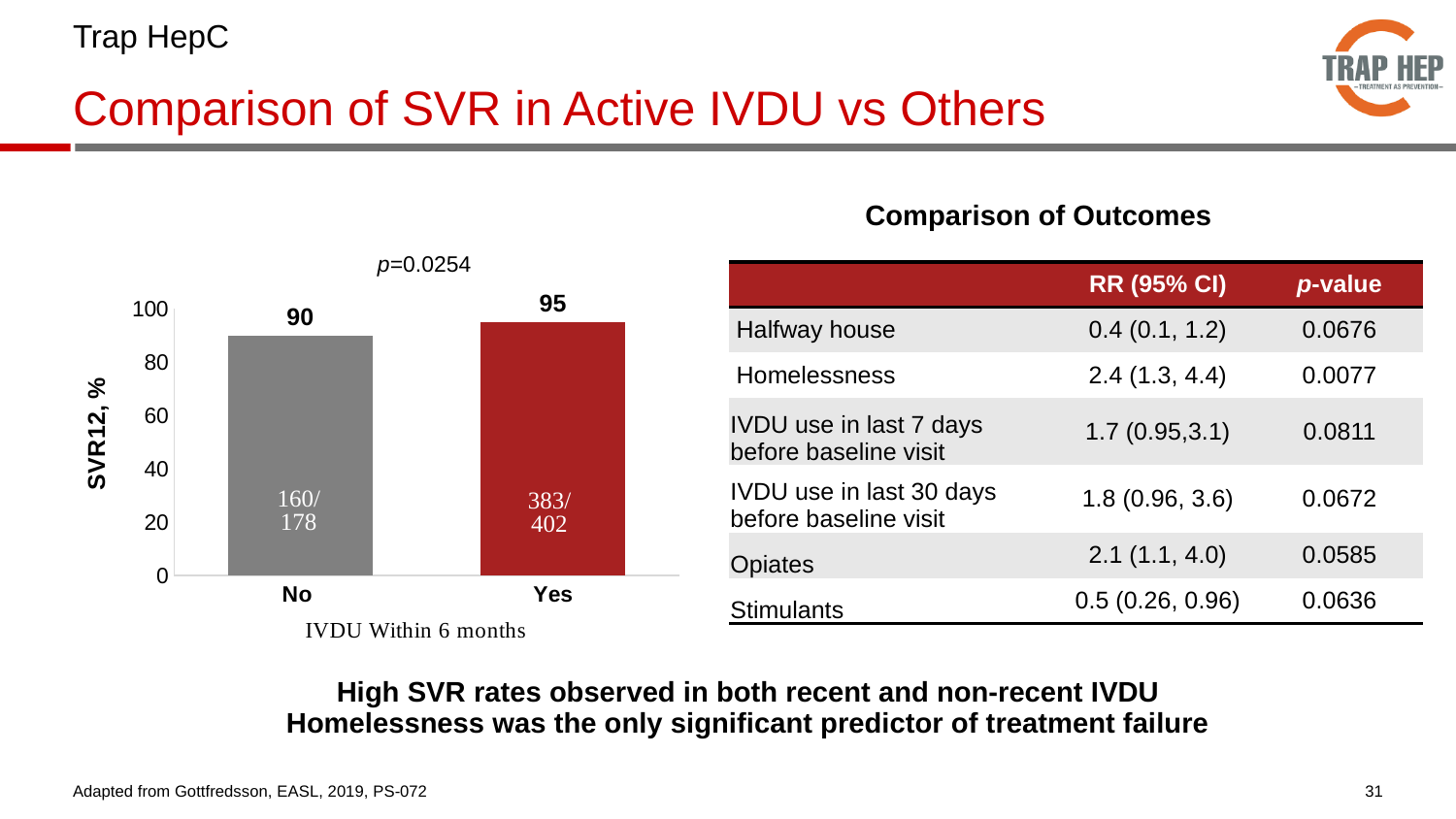
What kind of chart is used to show SVR12 by IVDU within 6 months? Bar chart Which group has the lower SVR12 percentage? No What is the difference in SVR12 between the 'Yes' and 'No' groups? 5 What fraction is printed inside the 'No' bar? 160/178 What fraction is printed inside the 'Yes' bar? 383/402 What p-value is shown above the bar chart? p=0.0254 What is the SVR12 value for the 'Yes' IVDU within 6 months group? 95 Which group has the higher SVR12 percentage, 'No' or 'Yes'? Yes What is the SVR12 value for the 'No' IVDU within 6 months group? 90 Is the SVR12 value for the 'No' group greater or less than 80? greater What is the label of the y axis of the bar chart? SVR12, % How many categories are shown on the x axis of the bar chart? 2